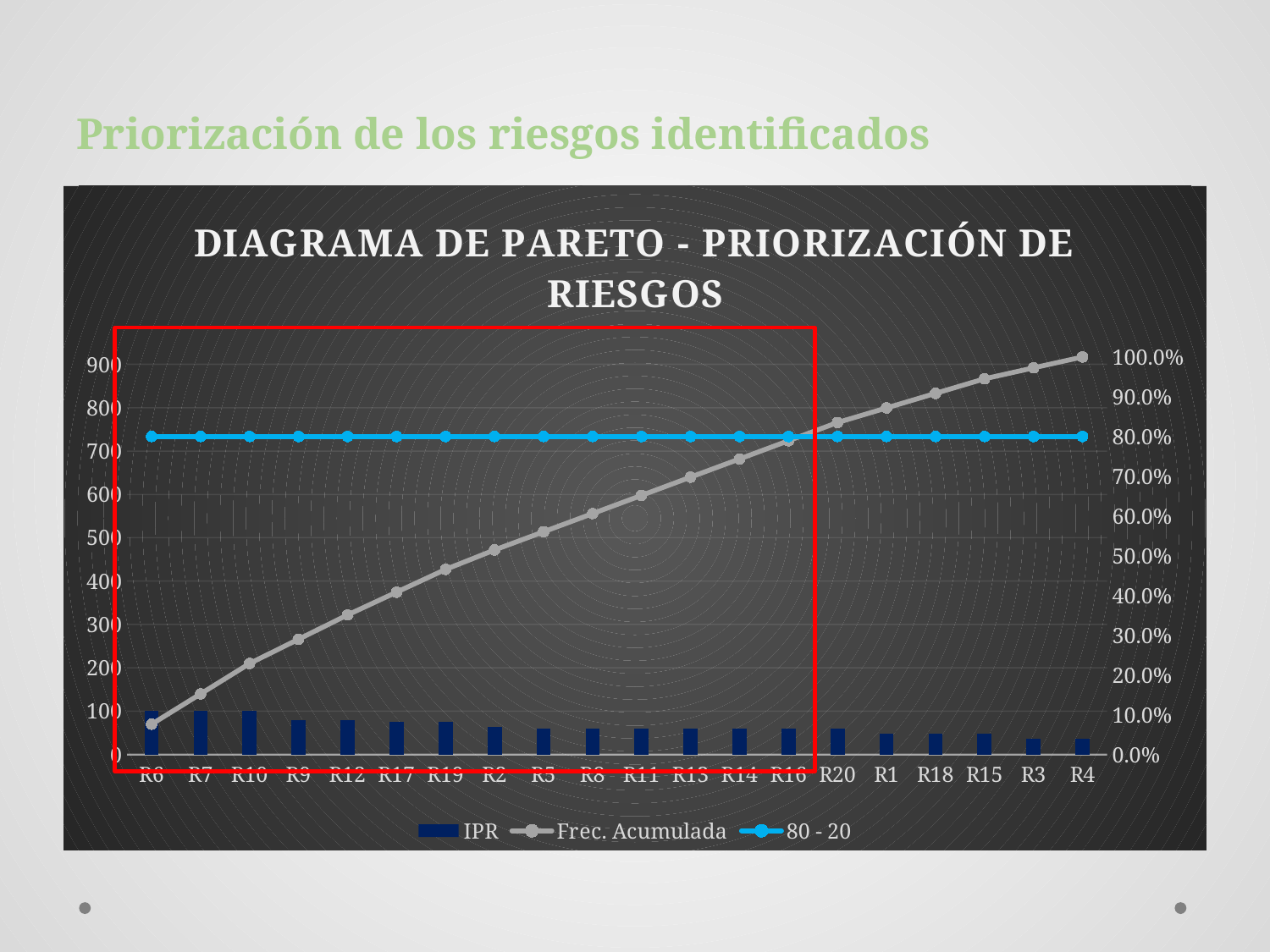
What are the series names listed in the chart legend? IPR, Frec. Acumulada, 80 - 20 Which has the larger IPR bar, R6 or R4? R6 What is the title of the chart? DIAGRAMA DE PARETO - PRIORIZACIÓN DE RIESGOS Does the Frec. Acumulada line rise or fall from R6 to R4 along the x axis? Rise What kind of chart is shown on the slide? Combined bar and line chart What value does the 80 - 20 line hold across all categories? 80.0% How many risk categories are shown on the x axis of the chart? 20 Is the Frec. Acumulada value for R6 greater or less than 10.0%? less Is the Frec. Acumulada value for R20 greater or less than 80.0%? greater What is the Frec. Acumulada value at R4, the last category? 100.0% How many series does the chart legend list? 3 Is the Frec. Acumulada value for R14 greater or less than 80.0%? less